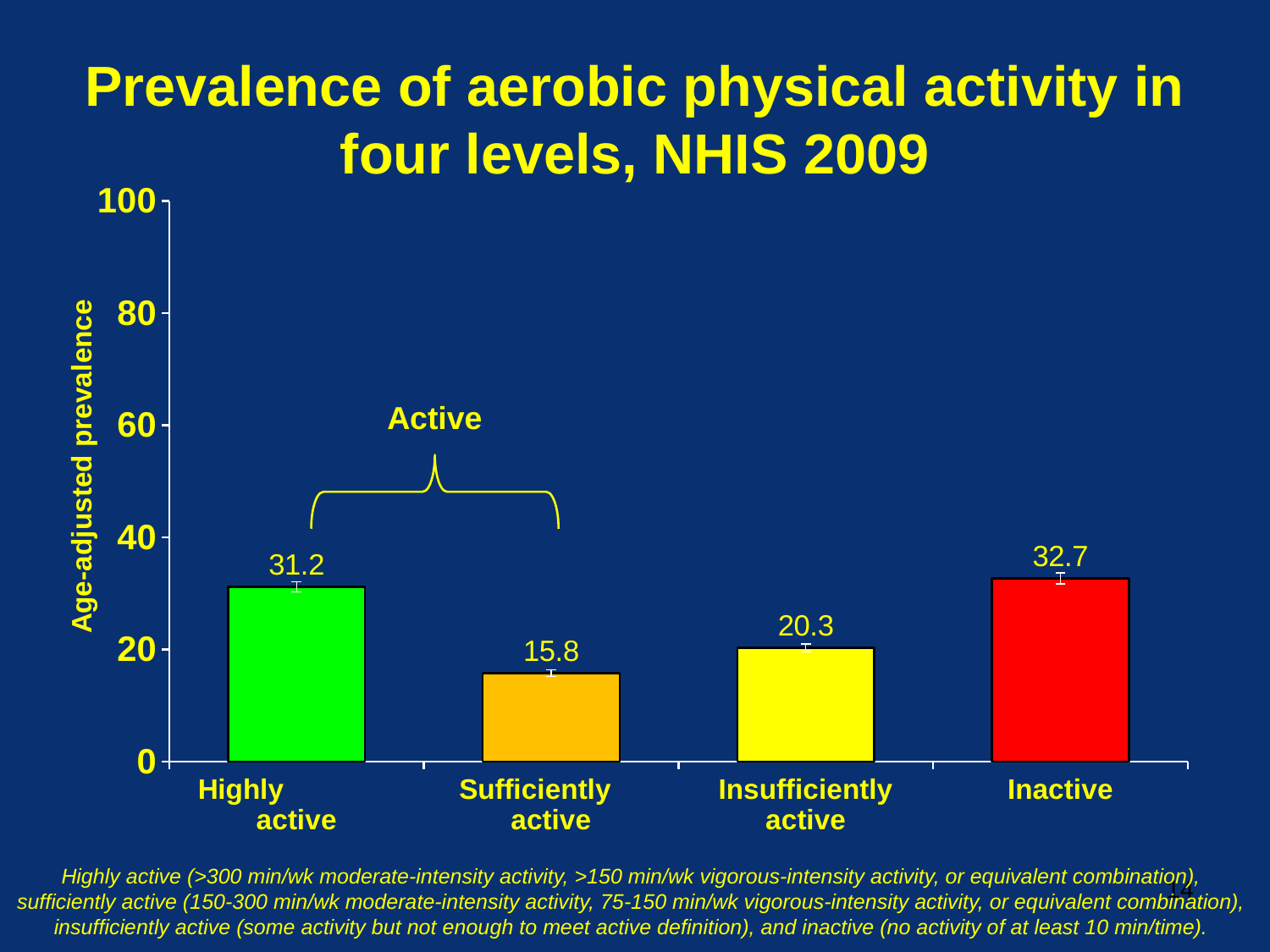
Which category has the highest age-adjusted prevalence? Inactive What kind of chart is shown on the slide? Bar chart What is the age-adjusted prevalence for the Highly active category? 31.2 Which is larger, the prevalence for Highly active or for Insufficiently active? Highly active Is the value for Sufficiently active greater or less than 20? less What is the age-adjusted prevalence for the Inactive category? 32.7 How many categories are shown on the x axis? 4 What is the age-adjusted prevalence for the Sufficiently active category? 15.8 What is the age-adjusted prevalence for the Insufficiently active category? 20.3 What is the difference between the Inactive and Highly active prevalence values? 1.5 What is the difference between the Insufficiently active and Sufficiently active prevalence values? 4.5 Which category has the lowest age-adjusted prevalence? Sufficiently active